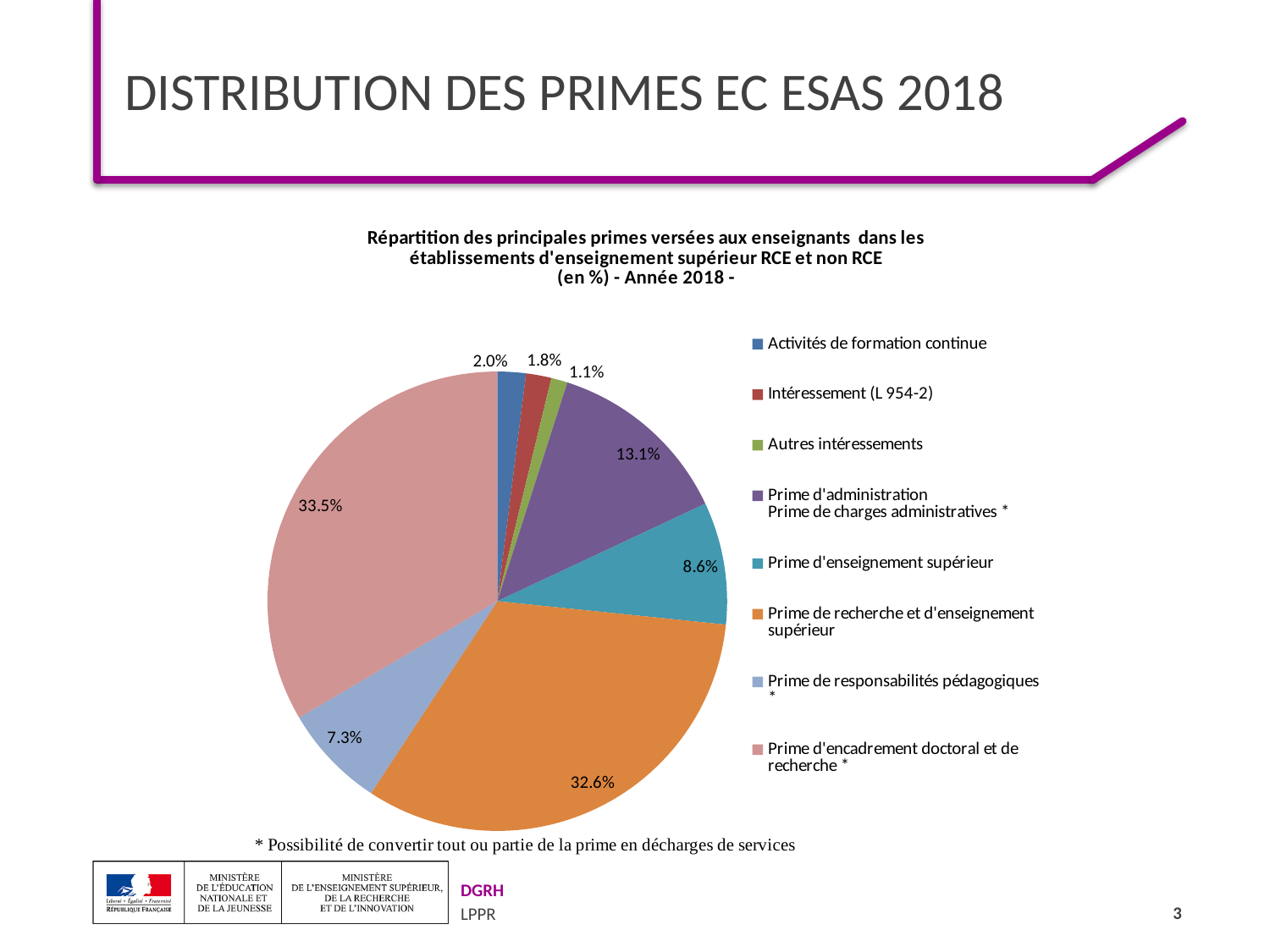
What is the value for Prime d'enseignement supérieur? 8.6% How many slices does the pie chart have? 8 Which category has the smallest share of the pie? Autres intéressements How many entries does the legend list? 8 Which category has the largest share of the pie? Prime d'encadrement doctoral et de recherche What is the difference between the shares of Prime d'administration / Prime de charges administratives and Prime d'enseignement supérieur? 4.5% What is the value for Prime d'administration / Prime de charges administratives? 13.1% What share of the pie is Prime d'encadrement doctoral et de recherche? 33.5% What kind of chart is shown on the slide? pie chart Which is larger, the share for Activités de formation continue or the share for Intéressement (L 954-2)? Activités de formation continue What share of the pie is Prime de recherche et d'enseignement supérieur? 32.6% What is the value for Prime de responsabilités pédagogiques? 7.3%